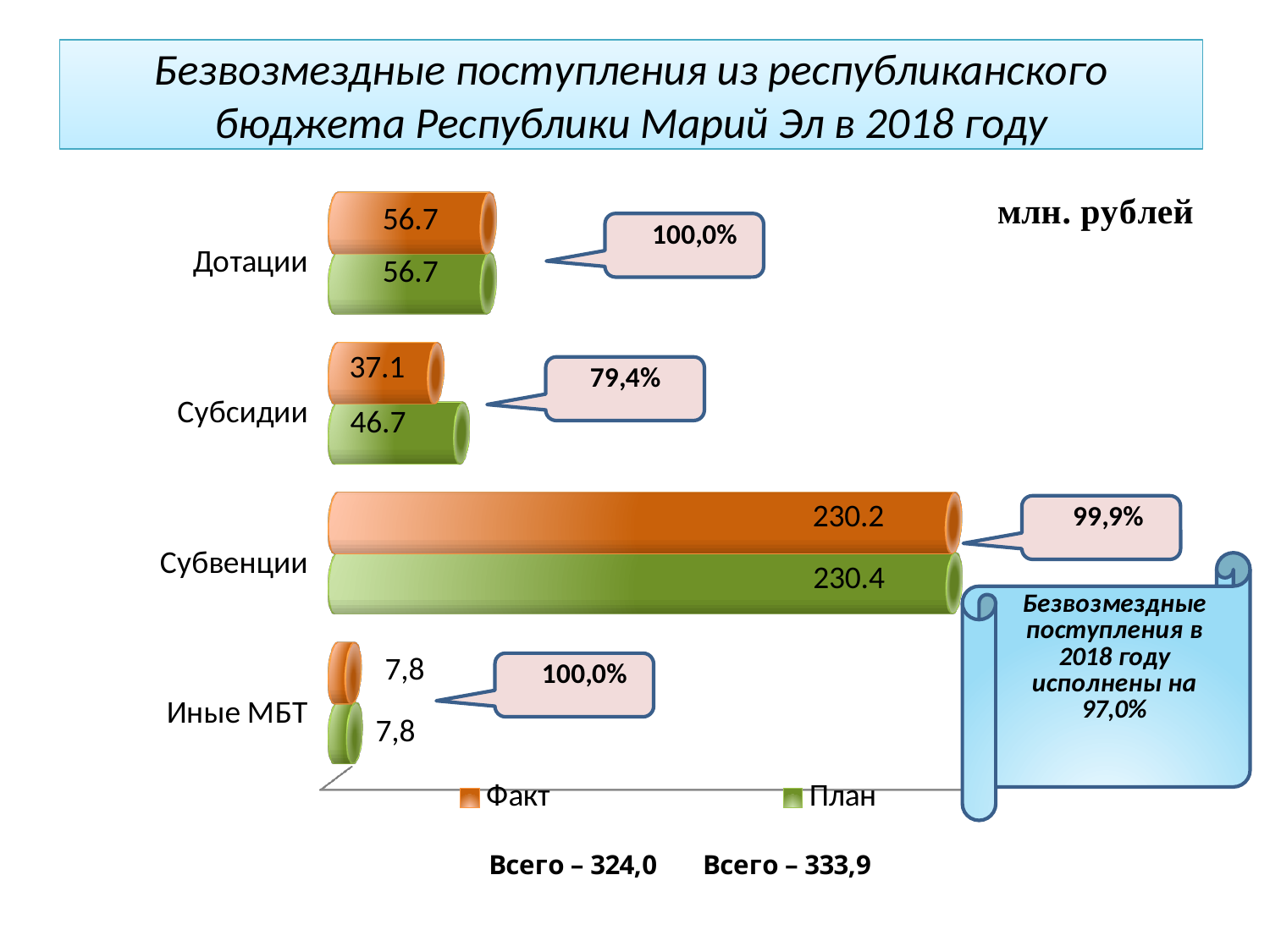
How many categories are shown in the chart? 4 How many series does the legend list? 2 What is the План value for Субсидии? 46.7 Which category has the lowest Факт value? Иные МБТ What is the Факт value for Субвенции? 230.2 What is the Факт value for Иные МБТ? 7,8 Which is larger for Субсидии, the Факт value or the План value? План Which category has the highest План value? Субвенции What is the План value for Дотации? 56.7 What kind of chart is shown on the slide? Bar chart What is the difference between the План and Факт values for Субсидии? 9.6 What is the Факт value for Субсидии? 37.1